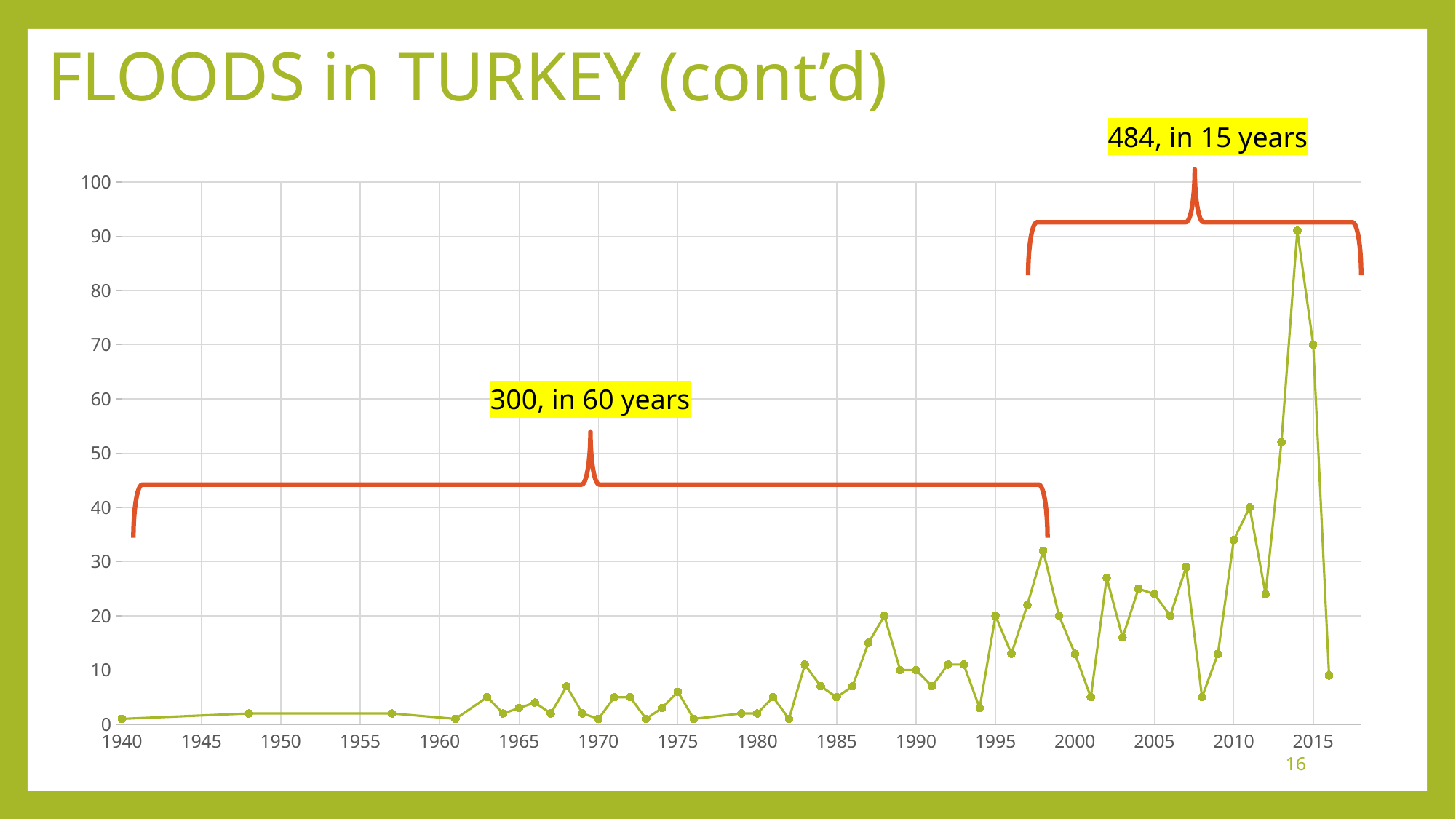
Is the value for 1998 greater or less than 20? greater Is the value for 2011 greater or less than 30? greater In which year does the line reach its highest value? 2014 Is the value for 2015 greater or less than 60? greater What does the annotation above the bracket covering 1940 to 1998 say? 300, in 60 years Which year has the larger value, 2014 or 2015? 2014 What kind of chart is shown on the slide? line chart Which year has the larger value, 1970 or 2010? 2010 Overall, do the values rise or fall from 1940 to 2014? rise